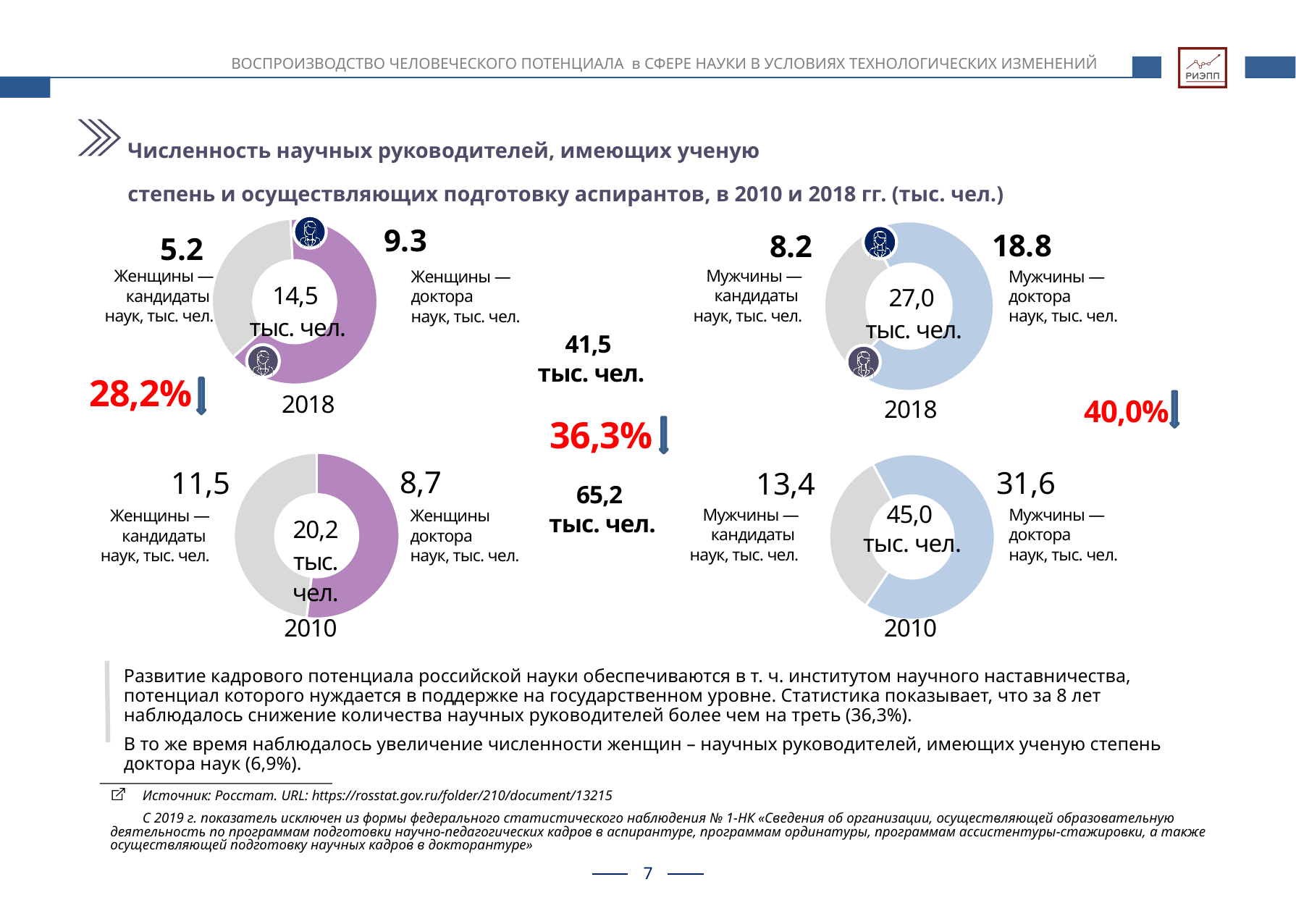
На диаграмме «Женщины, 2010» какая категория имеет наименьшее значение? Женщины — доктора наук На диаграмме «Мужчины, 2018» какое значение указано для категории «Мужчины — доктора наук»? 18.8 На диаграмме «Мужчины, 2010» какое значение указано для категории «Мужчины — кандидаты наук»? 13,4 На диаграмме «Женщины, 2010» какое значение указано для категории «Женщины — кандидаты наук»? 11,5 Какого типа диаграммы представлены на слайде? Кольцевые (круговые) диаграммы Что больше на диаграмме «Женщины, 2018»: значение для кандидатов наук или для докторов наук? Женщины — доктора наук На диаграмме «Мужчины, 2010» на сколько значение для докторов наук больше значения для кандидатов наук? 18,2 Какое общее значение указано в центре диаграммы «Мужчины, 2010»? 45,0 тыс. чел. Сколько кольцевых диаграмм представлено на слайде? 4 На диаграмме «Женщины, 2018» какое значение указано для категории «Женщины — кандидаты наук»? 5.2 На диаграмме «Женщины, 2018» какое значение указано для категории «Женщины — доктора наук»? 9.3 На диаграмме «Мужчины, 2018» какая категория имеет наибольшее значение? Мужчины — доктора наук